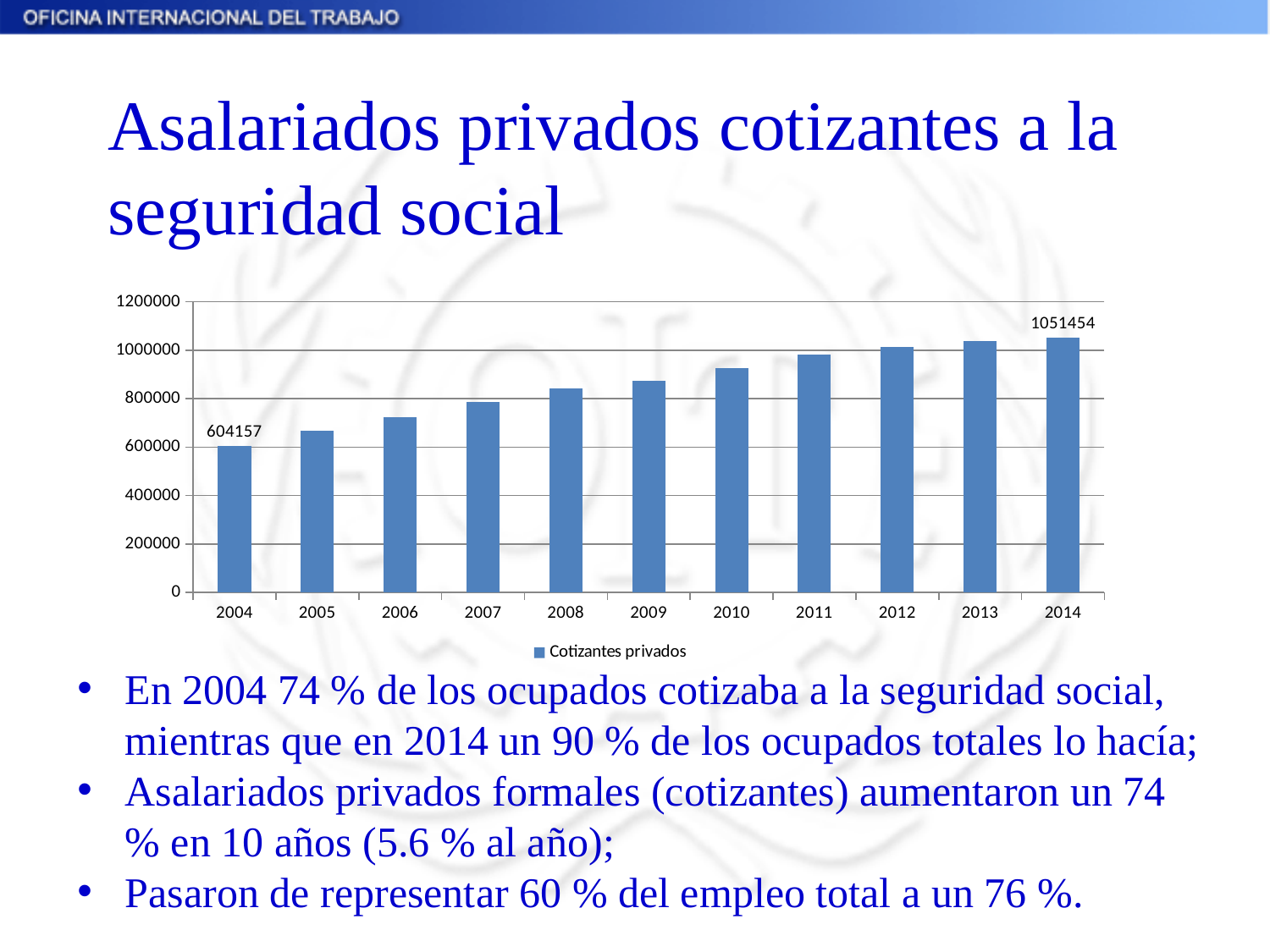
Is the value for 2009 greater or less than 800000? greater Is the value for 2007 greater or less than 800000? less What is the difference between the values for 2014 and 2004? 447297 What is the value for 2004 in the chart? 604157 What is the value for 2014 in the chart? 1051454 What kind of chart is shown on the slide? bar chart Which year has the highest value in the chart? 2014 Which year has the lowest value in the chart? 2004 How many years are shown on the x axis of the chart? 11 Is the value for 2011 greater or less than 1000000? less Do the values rise or fall from 2004 to 2014? rise Which year has a larger value, 2006 or 2010? 2010